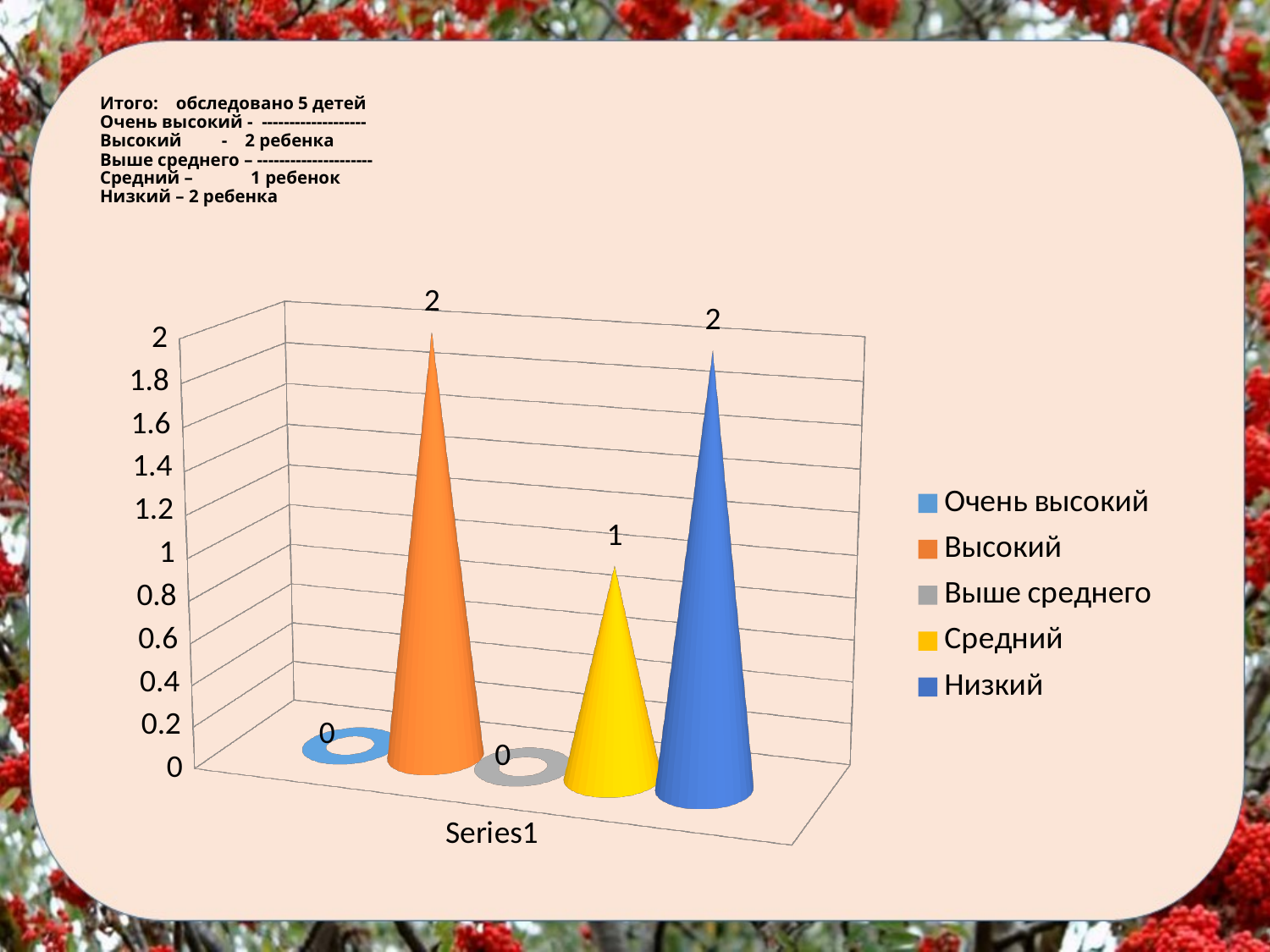
What is the total of all the values plotted in the chart? 5 What is the value for Низкий? 2 What kind of chart is shown on the slide? bar chart What is the difference between the values for Высокий and Средний? 1 What is the value for Высокий? 2 How many series does the legend list? 5 What is the value for Средний? 1 Is the value for Средний greater or less than 1.5? less What is the value for Очень высокий? 0 What is the value for Выше среднего? 0 Which is larger, the value for Средний or the value for Низкий? Низкий What label is shown on the horizontal axis of the chart? Series1